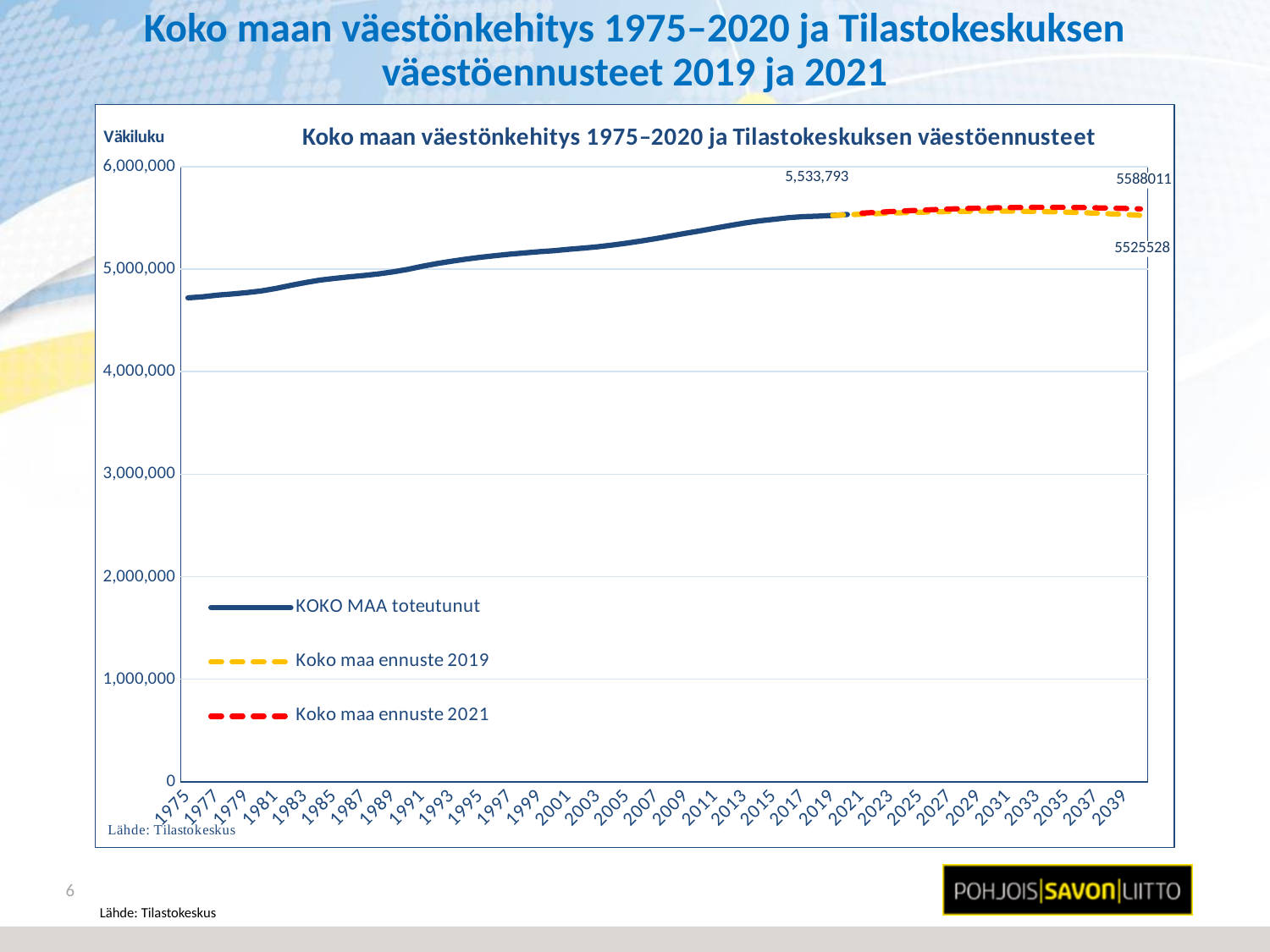
How many series does the legend list? 3 What kind of chart is shown on the slide? line chart What colour is the Koko maa ennuste 2019 line? yellow Does the KOKO MAA toteutunut line rise or fall from 1975 to 2020? rises Which forecast line ends higher, Koko maa ennuste 2019 or Koko maa ennuste 2021? Koko maa ennuste 2021 What value is labelled at the end of the KOKO MAA toteutunut line? 5,533,793 What is the label on the vertical axis of the chart? Väkiluku What is the final labelled value of the Koko maa ennuste 2019 line? 5525528 Is the value for KOKO MAA toteutunut in 1975 greater or less than 5,000,000? less Is the value for KOKO MAA toteutunut in 2019 greater or less than 5,000,000? greater What is the difference between the final labelled values of Koko maa ennuste 2021 and Koko maa ennuste 2019? 62483 What is the final labelled value of the Koko maa ennuste 2021 line? 5588011